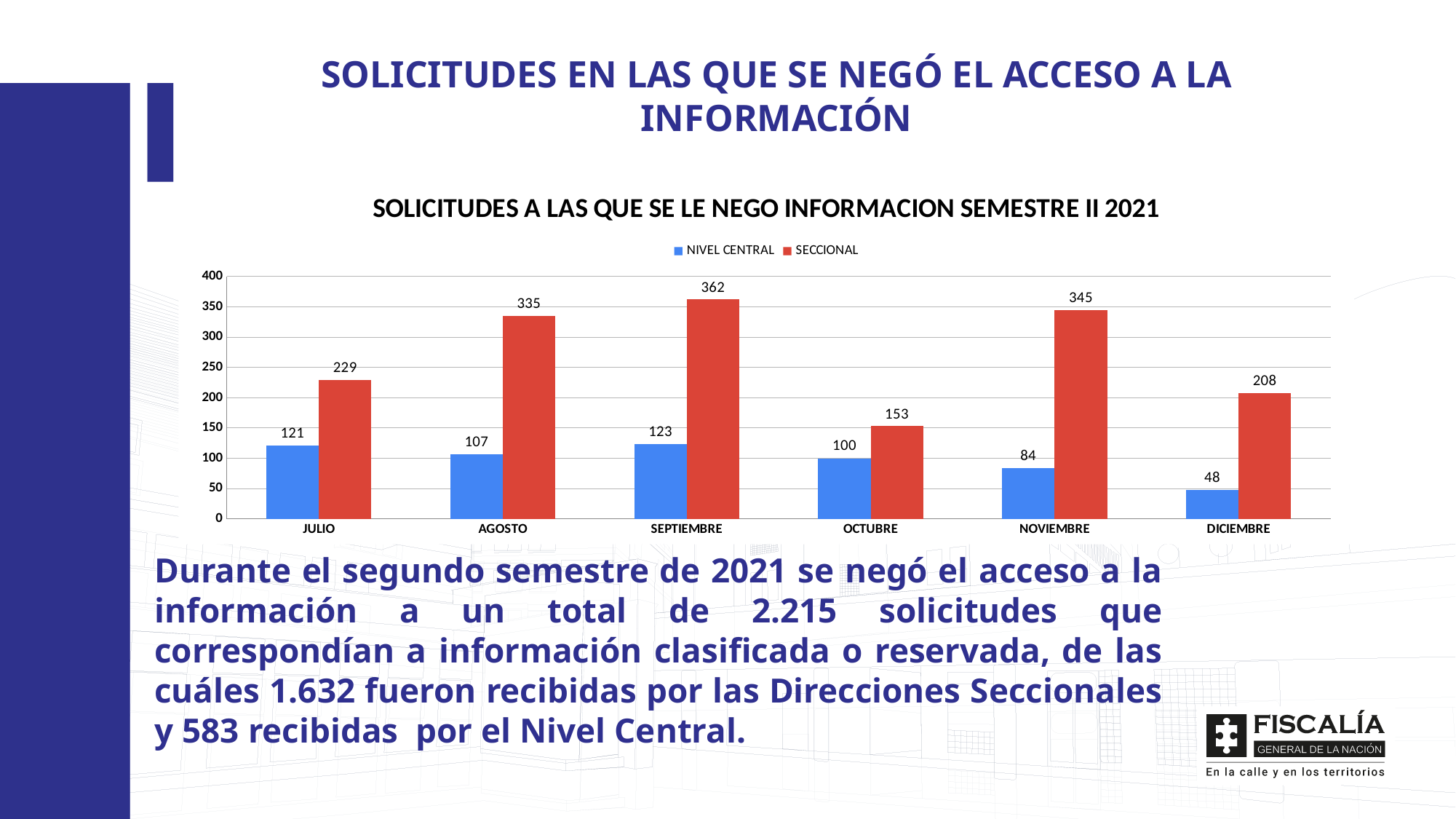
What is the SECCIONAL value for SEPTIEMBRE? 362 Which is larger, the SECCIONAL value for OCTUBRE or the SECCIONAL value for JULIO? JULIO What is the NIVEL CENTRAL value for JULIO? 121 Which month has the highest SECCIONAL value? SEPTIEMBRE Which month has the lowest NIVEL CENTRAL value? DICIEMBRE Does the NIVEL CENTRAL series rise or fall from OCTUBRE to DICIEMBRE? Fall How many months are shown on the x axis? 6 How many series does the legend list? 2 What colour are the SECCIONAL bars? Red What kind of chart is shown? Bar chart What is the difference between the SECCIONAL and NIVEL CENTRAL values for AGOSTO? 228 What is the SECCIONAL value for DICIEMBRE? 208